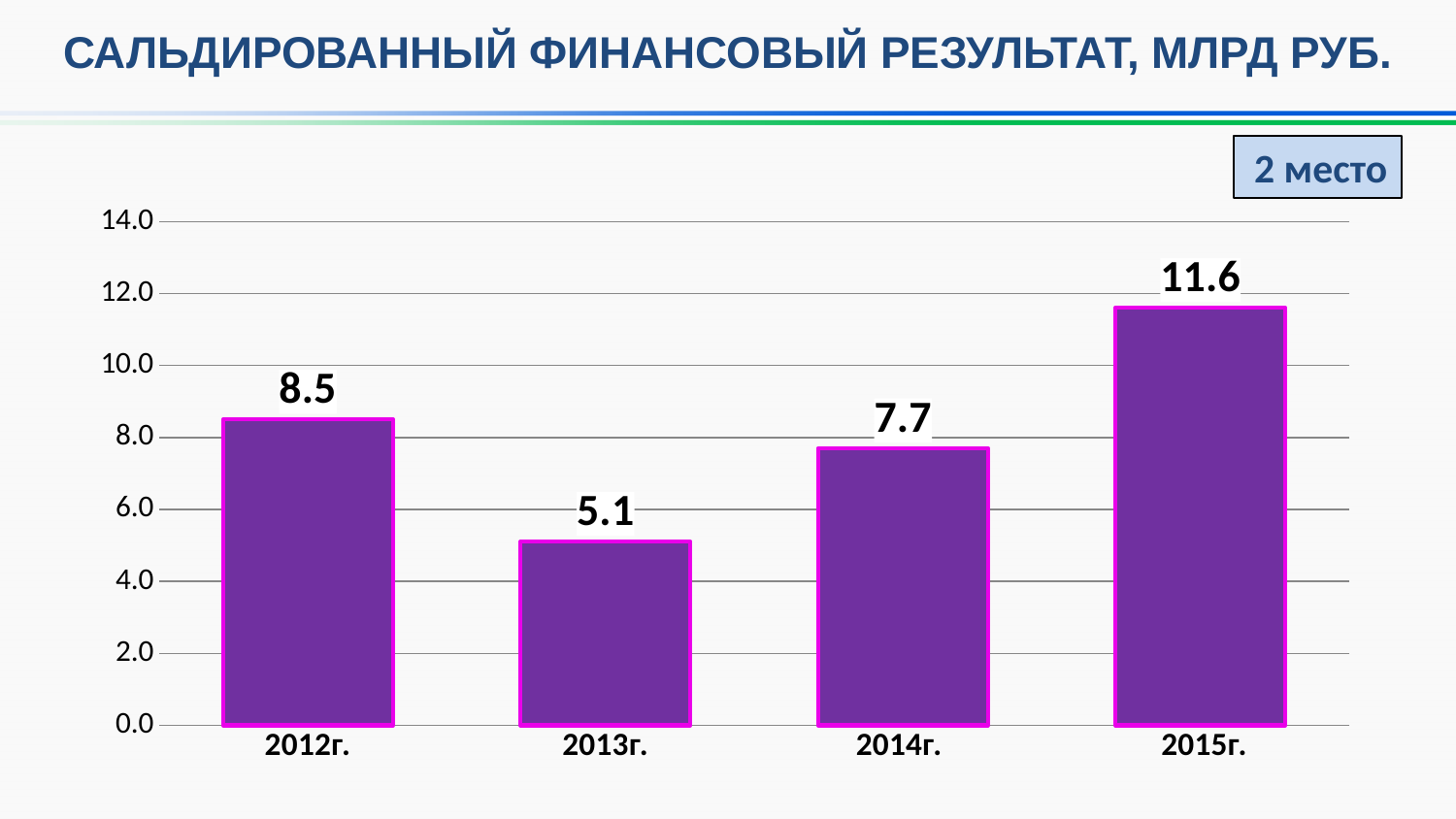
What is the value for 2012г.? 8.5 Is the value for 2015г. greater or less than 10.0? greater What is the value for 2015г.? 11.6 What is the title of the chart? САЛЬДИРОВАННЫЙ ФИНАНСОВЫЙ РЕЗУЛЬТАТ, МЛРД РУБ. How many years are shown on the chart? 4 What is the difference between the values for 2015г. and 2012г.? 3.1 Which is larger, the value for 2012г. or the value for 2014г.? 2012г. What is the value for 2014г.? 7.7 What is the value for 2013г.? 5.1 Which year has the lowest value? 2013г. What kind of chart is shown on the slide? bar chart Which year has the highest value? 2015г.